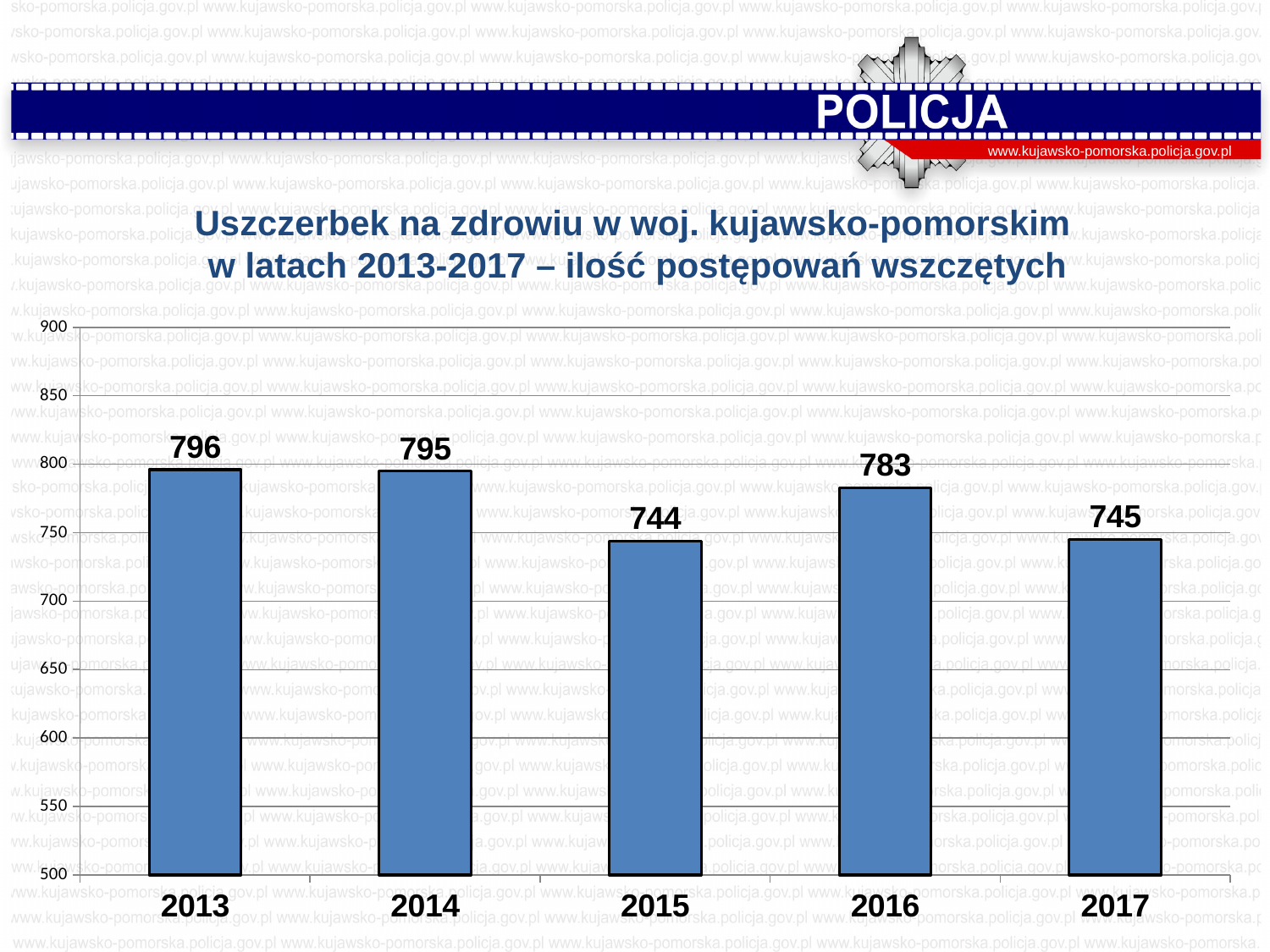
How many years are shown on the x axis? 5 What is the value for 2013? 796 Which is larger, the value for 2014 or the value for 2016? 2014 What is the difference between the values for 2013 and 2015? 52 What is the value for 2015? 744 What kind of chart is shown on the slide? bar chart Is the value for 2015 greater or less than 750? less Do the values rise or fall from 2013 to 2015? fall What is the difference between the values for 2016 and 2017? 38 What is the value for 2017? 745 What is the value for 2016? 783 Is the value for 2016 greater or less than 750? greater